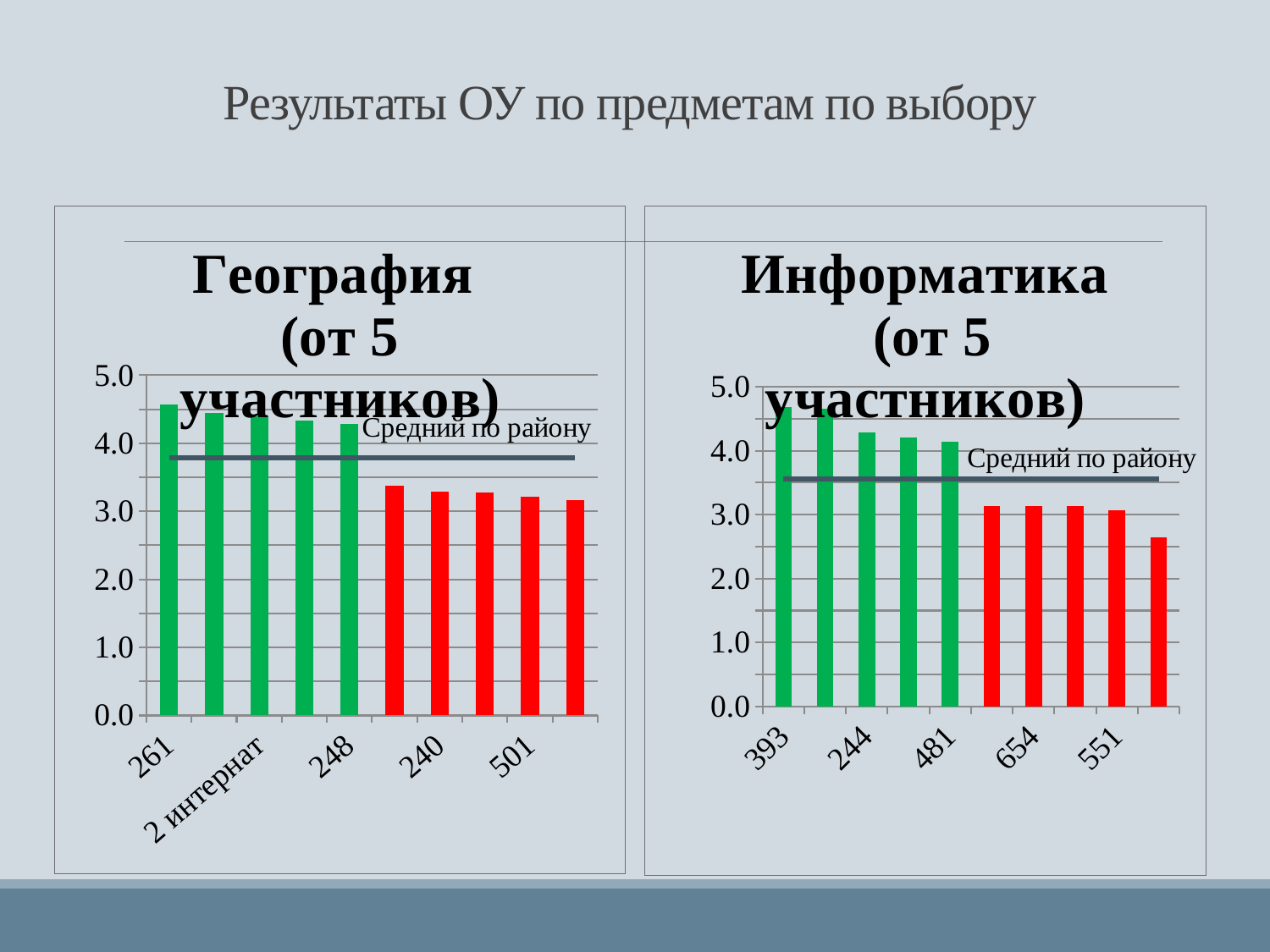
In the "География (от 5 участников)" chart, do the bar values rise or fall from left to right? fall How many bars are plotted in the "Информатика (от 5 участников)" chart? 10 What is the label of the horizontal line drawn across the "Информатика (от 5 участников)" chart? Средний по району What colour are the bars to the right of the green bars in the "География (от 5 участников)" chart? red In the "Информатика (от 5 участников)" chart, is the value for 393 greater or less than 4.0? greater In the "География (от 5 участников)" chart, is the value for 261 greater or less than 4.0? greater In the "География (от 5 участников)" chart, which has the larger value, 261 or 501? 261 In the "Информатика (от 5 участников)" chart, which has the larger value, 244 or 551? 244 In the "География (от 5 участников)" chart, is the value for 240 greater or less than 4.0? less In the "Информатика (от 5 участников)" chart, which labelled category has the highest value? 393 What kind of chart is the "География (от 5 участников)" chart? bar chart